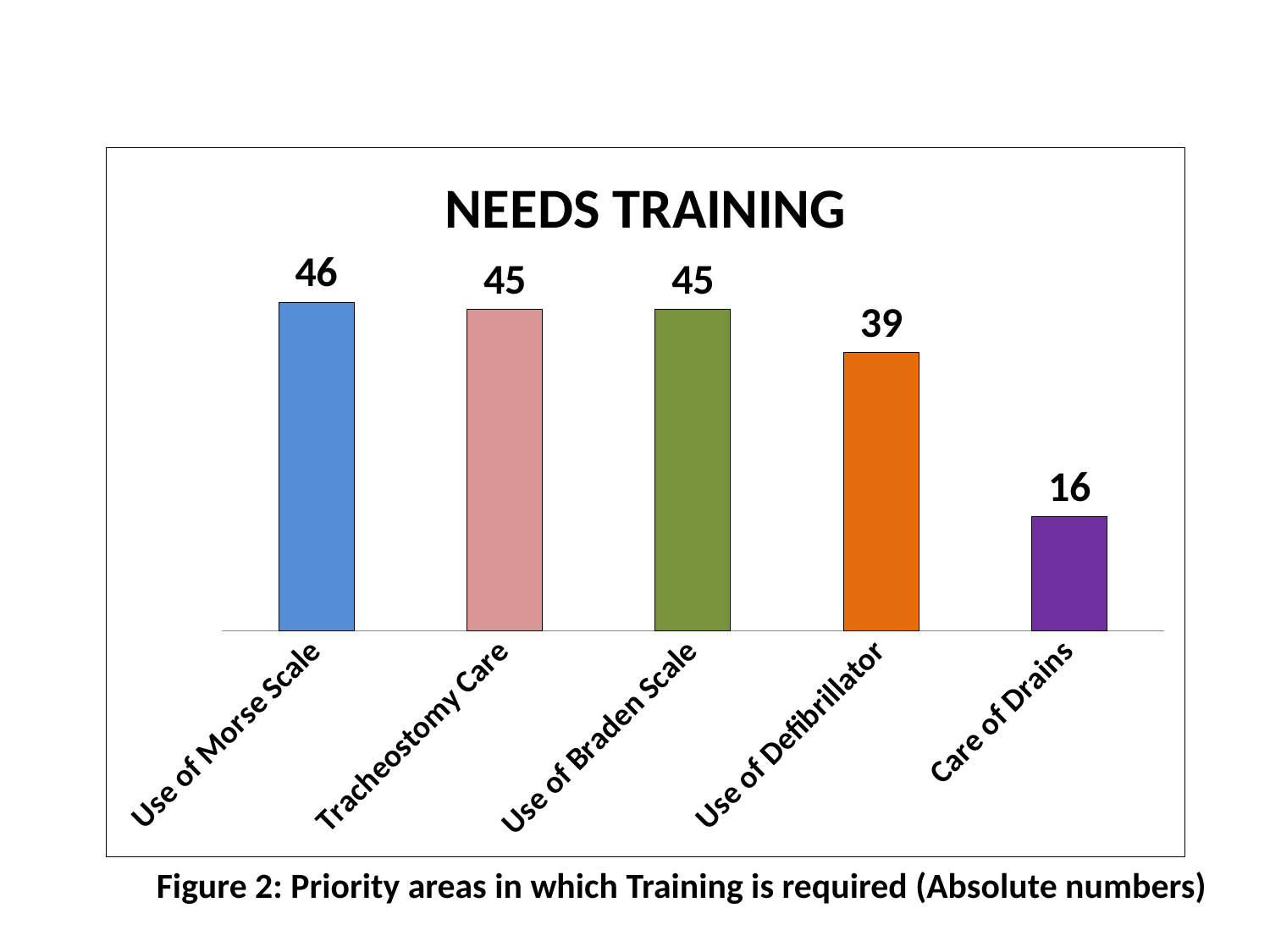
Which category has the highest value? Use of Morse Scale What is the value for Tracheostomy Care? 45 What is the value for Use of Morse Scale? 46 What is the difference between the values for Use of Morse Scale and Use of Braden Scale? 1 How many categories are shown in the chart? 5 What is the value for Care of Drains? 16 What is the difference between the values for Use of Defibrillator and Care of Drains? 23 What is the value for Use of Defibrillator? 39 Which is larger, the value for Use of Braden Scale or the value for Use of Defibrillator? Use of Braden Scale What is the title of the chart? NEEDS TRAINING What kind of chart is this? Bar chart Which category has the lowest value? Care of Drains